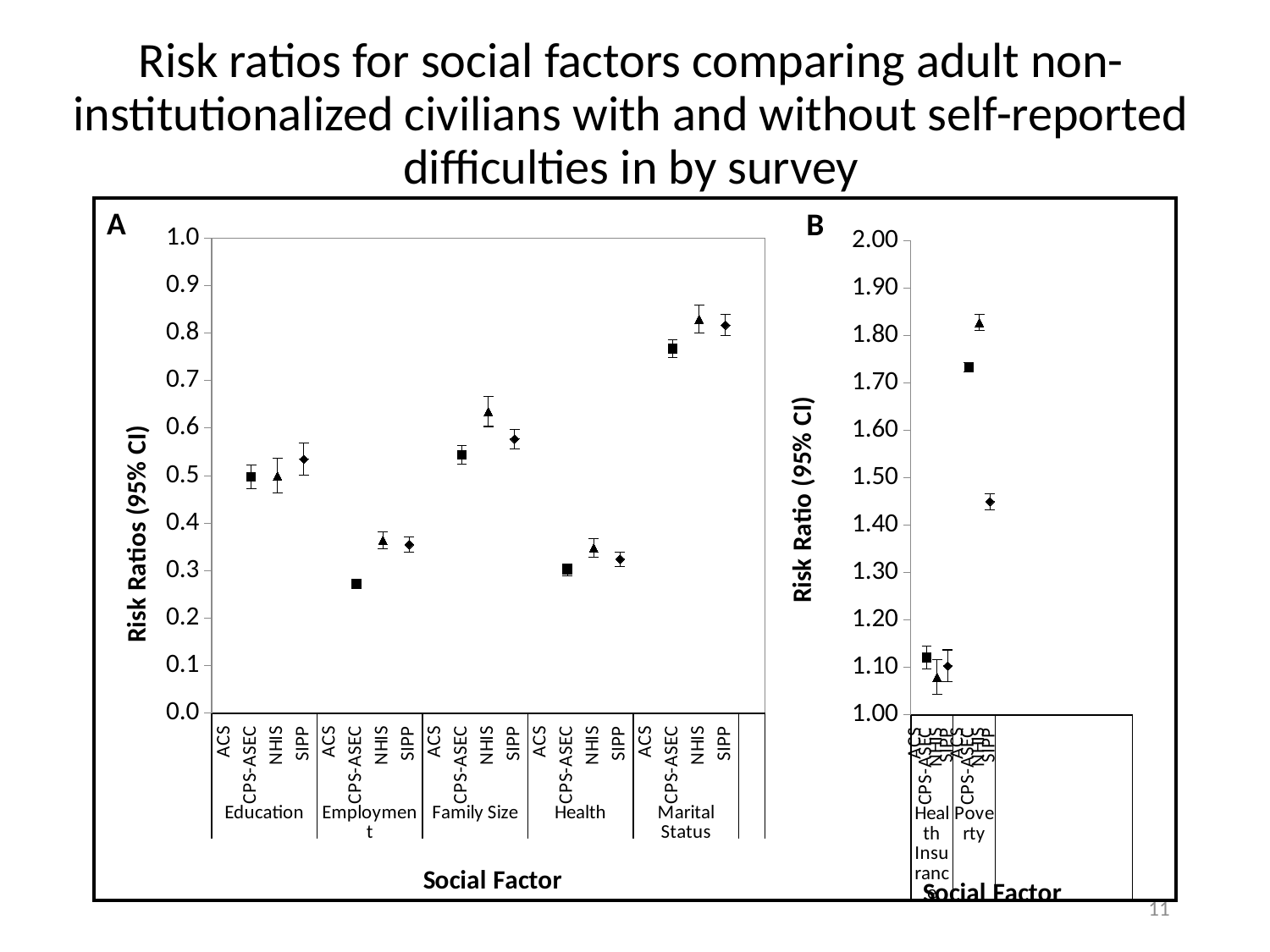
In chart A, is the value for CPS-ASEC under Employment greater or less than 0.3? less In chart B, is the value for NHIS under Poverty greater or less than 1.80? greater In chart B, is the value for SIPP under Poverty greater or less than 1.50? less What kind of chart is chart A on the left? scatter chart In chart B, which social factor has the higher risk ratios, Health Insurance or Poverty? Poverty In chart A, which social factor has the highest risk ratios? Marital Status In chart A, which survey point has the lowest risk ratio? CPS-ASEC under Employment In chart A, which is larger: the NHIS value for Family Size or the NHIS value for Education? NHIS value for Family Size In chart A, how many social factor categories are shown on the x axis? 5 What is the y-axis title of chart A? Risk Ratios (95% CI)